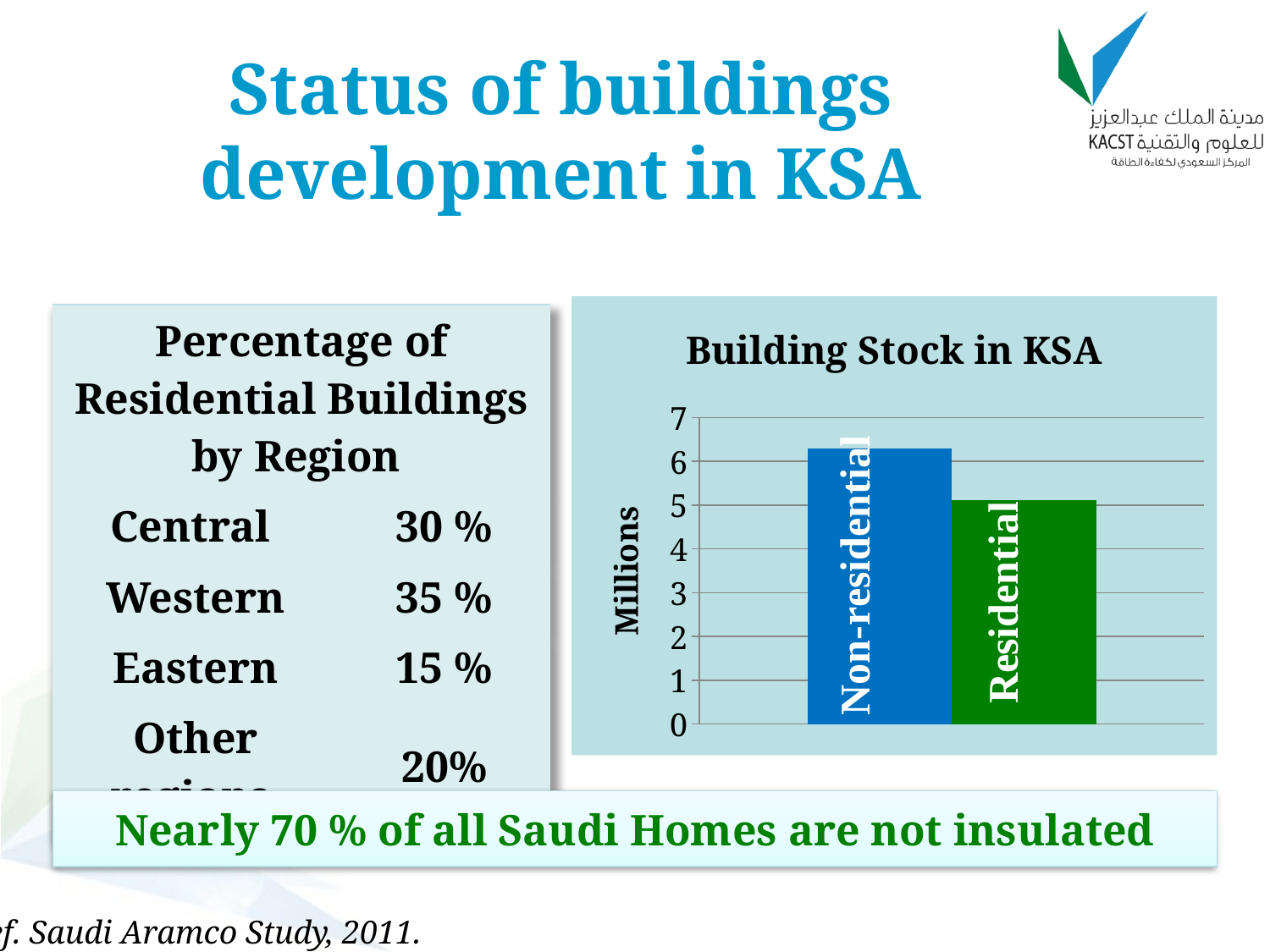
Which category has the highest value in the "Building Stock in KSA" chart? Non-residential In the "Building Stock in KSA" chart, which is larger, Non-residential or Residential? Non-residential Which category has the lowest value in the "Building Stock in KSA" chart? Residential In the "Building Stock in KSA" chart, is the value for Residential greater or less than 6? less In the "Building Stock in KSA" chart, is the value for Residential greater or less than 4? greater What colour is the Residential bar in the "Building Stock in KSA" chart? green In the "Building Stock in KSA" chart, is the value for Non-residential greater or less than 7? less How many bars are plotted in the "Building Stock in KSA" chart? 2 What is the label on the vertical axis of the "Building Stock in KSA" chart? Millions What kind of chart is the "Building Stock in KSA" chart? bar chart